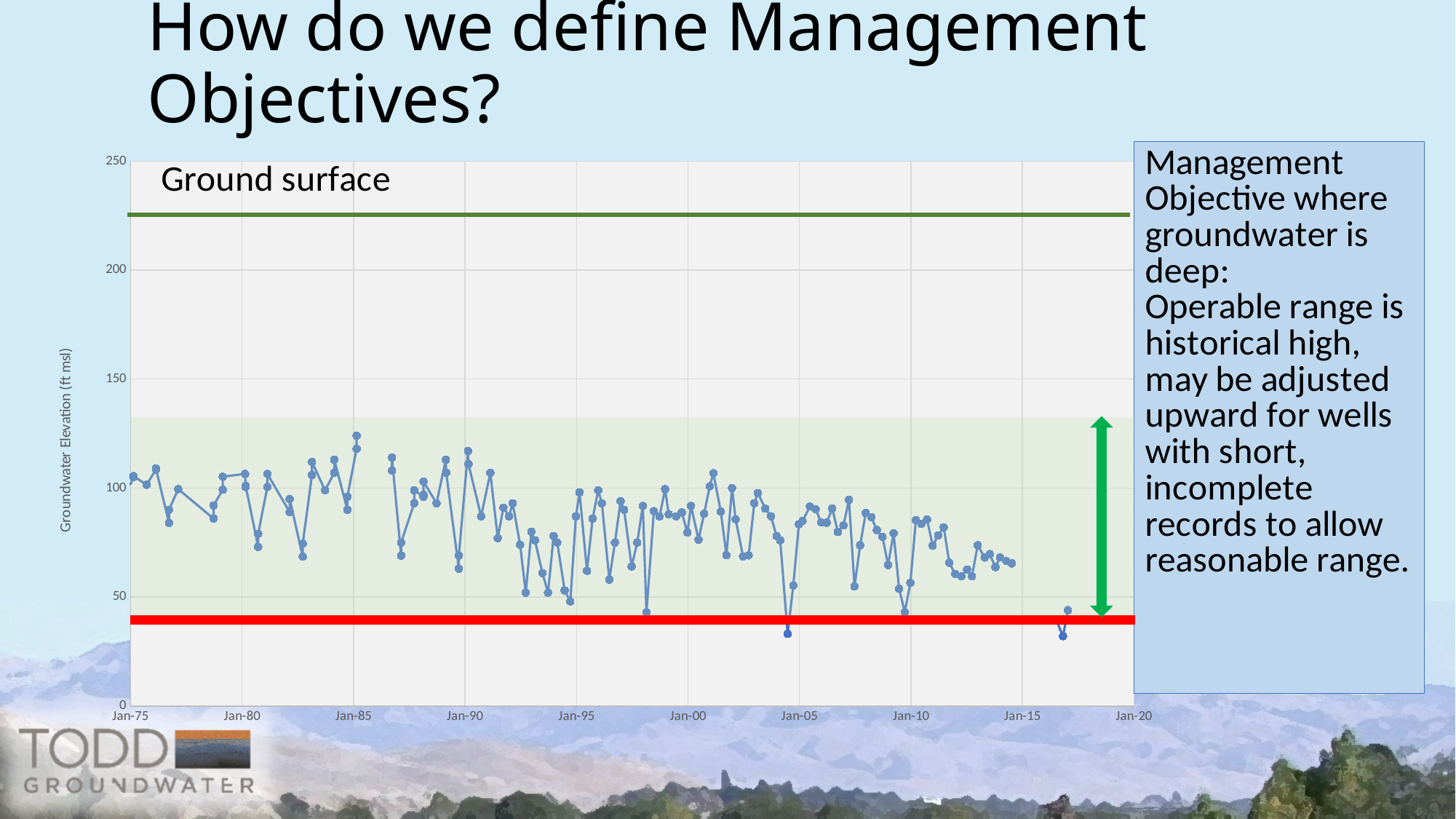
Is the green 'Ground surface' line greater or less than 200 on the vertical axis? greater Is the highest plotted groundwater elevation point greater or less than 150? less What is the highest value shown on the vertical axis of the chart? 250 Is the red horizontal line greater or less than 50 on the vertical axis? less What kind of chart is shown on the slide? line chart What is the first date label on the horizontal axis of the chart? Jan-75 How many labelled tick marks are on the horizontal (date) axis of the chart? 10 Do the plotted groundwater elevation values generally rise or fall from Jan-75 to Jan-15? fall What is the label on the vertical axis of the chart? Groundwater Elevation (ft msl) What is the last date label on the horizontal axis of the chart? Jan-20